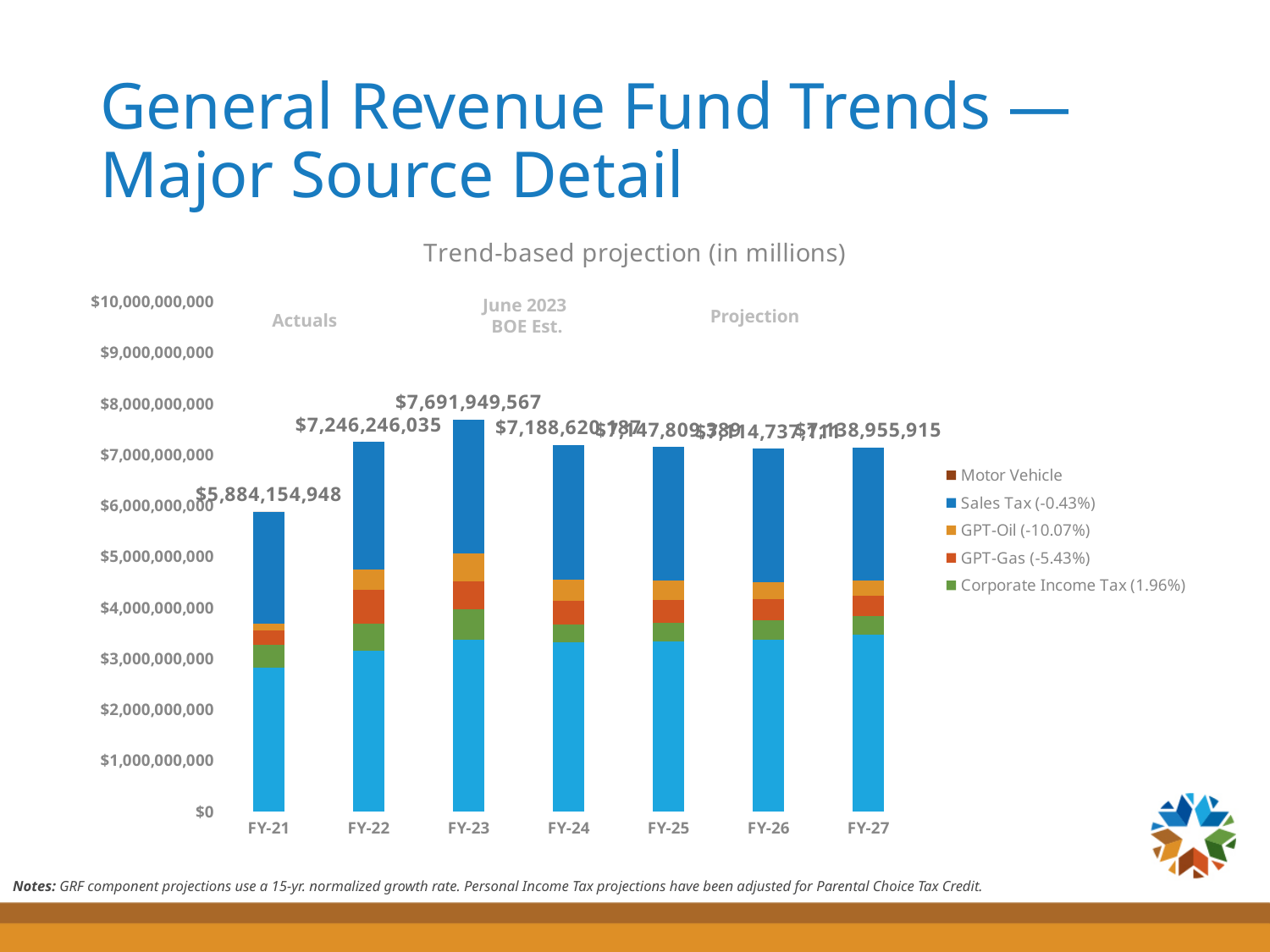
Which fiscal year has the lowest total? FY-21 What is the total value shown for FY-23? $7,691,949,567 What is the difference between the FY-23 total and the FY-22 total? $445,703,532 What is the total value shown for FY-21? $5,884,154,948 Which is larger, the total for FY-22 or the total for FY-21? FY-22 How many series does the legend list? 5 What is the total value shown for FY-22? $7,246,246,035 Which fiscal year has the highest total? FY-23 What kind of chart is shown? Stacked bar chart How many fiscal years are shown on the x axis? 7 Is the total for FY-21 greater or less than $6,000,000,000? less What is the total value shown for FY-27? $7,138,955,915